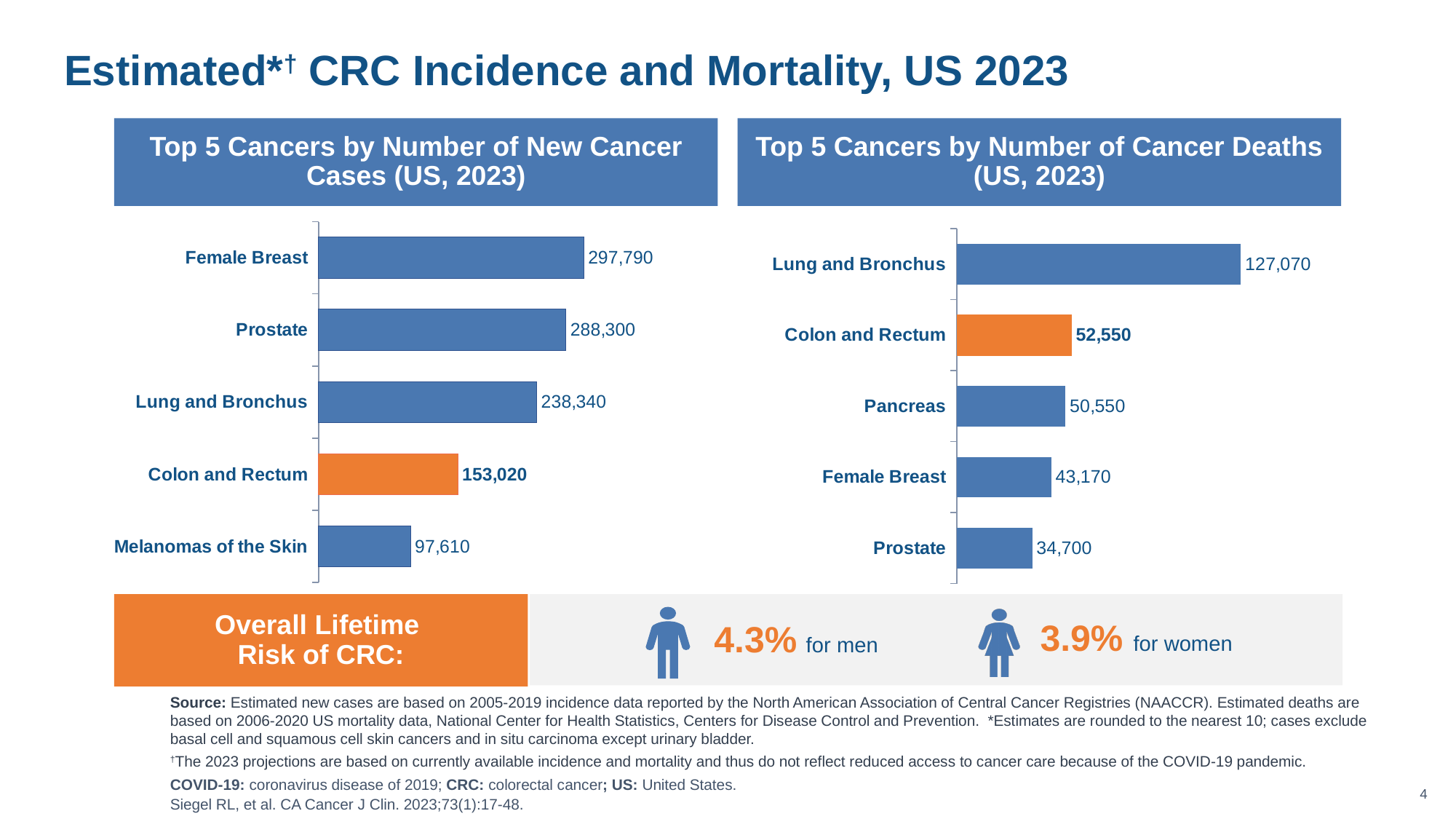
In the 'Top 5 Cancers by Number of Cancer Deaths (US, 2023)' chart, which is larger: Female Breast or Prostate? Female Breast In the 'Top 5 Cancers by Number of New Cancer Cases (US, 2023)' chart, what is the value for Melanomas of the Skin? 97,610 In the 'Top 5 Cancers by Number of Cancer Deaths (US, 2023)' chart, what is the value for Pancreas? 50,550 In the 'Top 5 Cancers by Number of Cancer Deaths (US, 2023)' chart, what is the difference between Lung and Bronchus and Colon and Rectum? 74,520 In the 'Top 5 Cancers by Number of New Cancer Cases (US, 2023)' chart, what is the difference between Female Breast and Prostate? 9,490 In the 'Top 5 Cancers by Number of Cancer Deaths (US, 2023)' chart, which category has the lowest value? Prostate What kind of chart is the 'Top 5 Cancers by Number of New Cancer Cases (US, 2023)' chart? Bar chart How many categories are shown in the 'Top 5 Cancers by Number of Cancer Deaths (US, 2023)' chart? 5 In the 'Top 5 Cancers by Number of New Cancer Cases (US, 2023)' chart, what is the value for Colon and Rectum? 153,020 In the 'Top 5 Cancers by Number of New Cancer Cases (US, 2023)' chart, which category has the highest value? Female Breast In the 'Top 5 Cancers by Number of New Cancer Cases (US, 2023)' chart, which is larger: Lung and Bronchus or Colon and Rectum? Lung and Bronchus In the 'Top 5 Cancers by Number of Cancer Deaths (US, 2023)' chart, which category's bar is coloured orange? Colon and Rectum